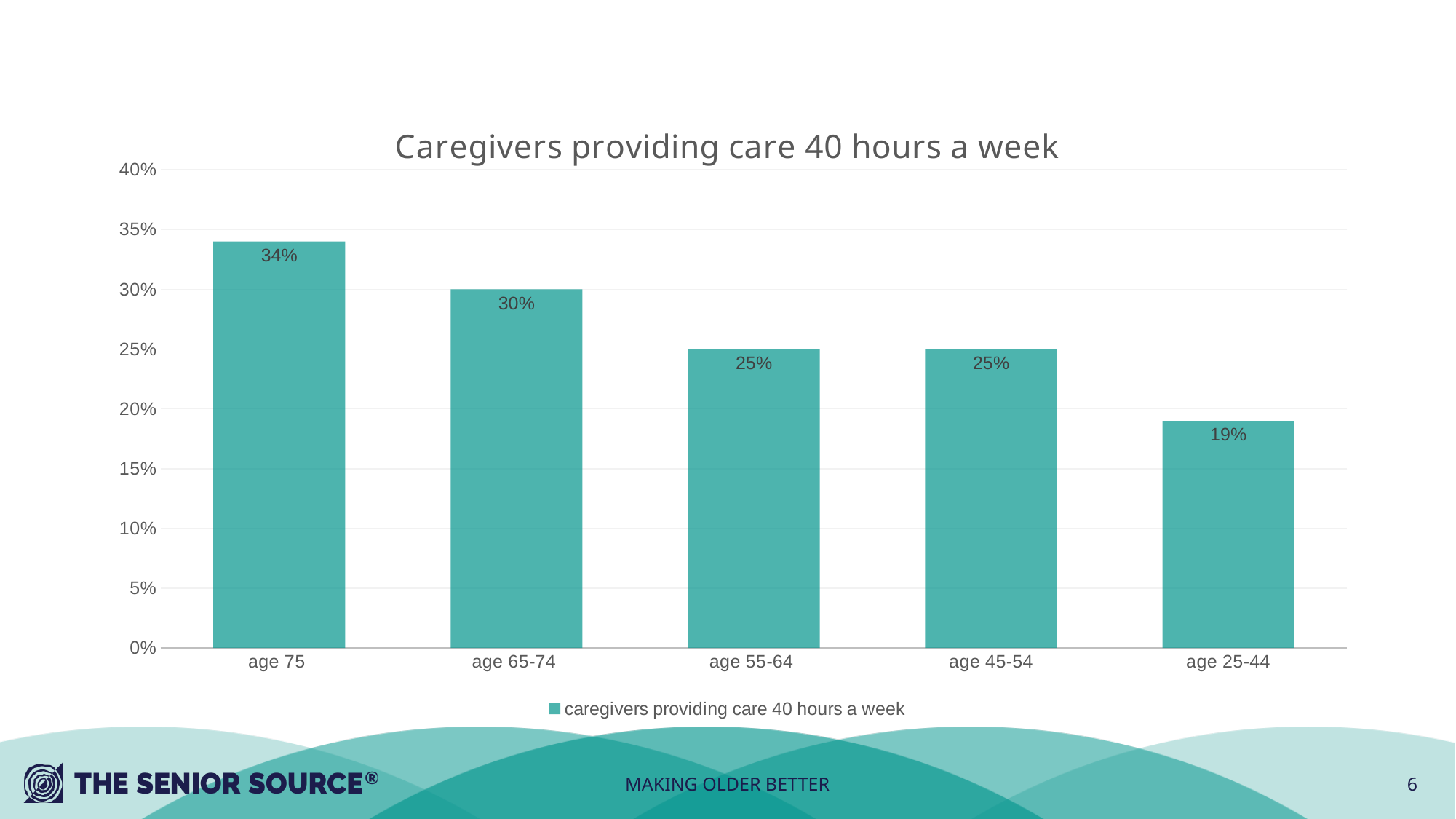
What is the value for age 25-44? 19% Which is larger, the value for age 65-74 or the value for age 45-54? age 65-74 Which age group has the highest value? age 75 How many age groups are shown on the chart? 5 What is the difference between the values for age 75 and age 25-44? 15% What is the value for age 75? 34% What is the value for age 55-64? 25% What is the difference between the values for age 65-74 and age 55-64? 5% What is the title of the chart? Caregivers providing care 40 hours a week What is the value for age 65-74? 30% What kind of chart is shown on the slide? bar chart Which age group has the lowest value? age 25-44